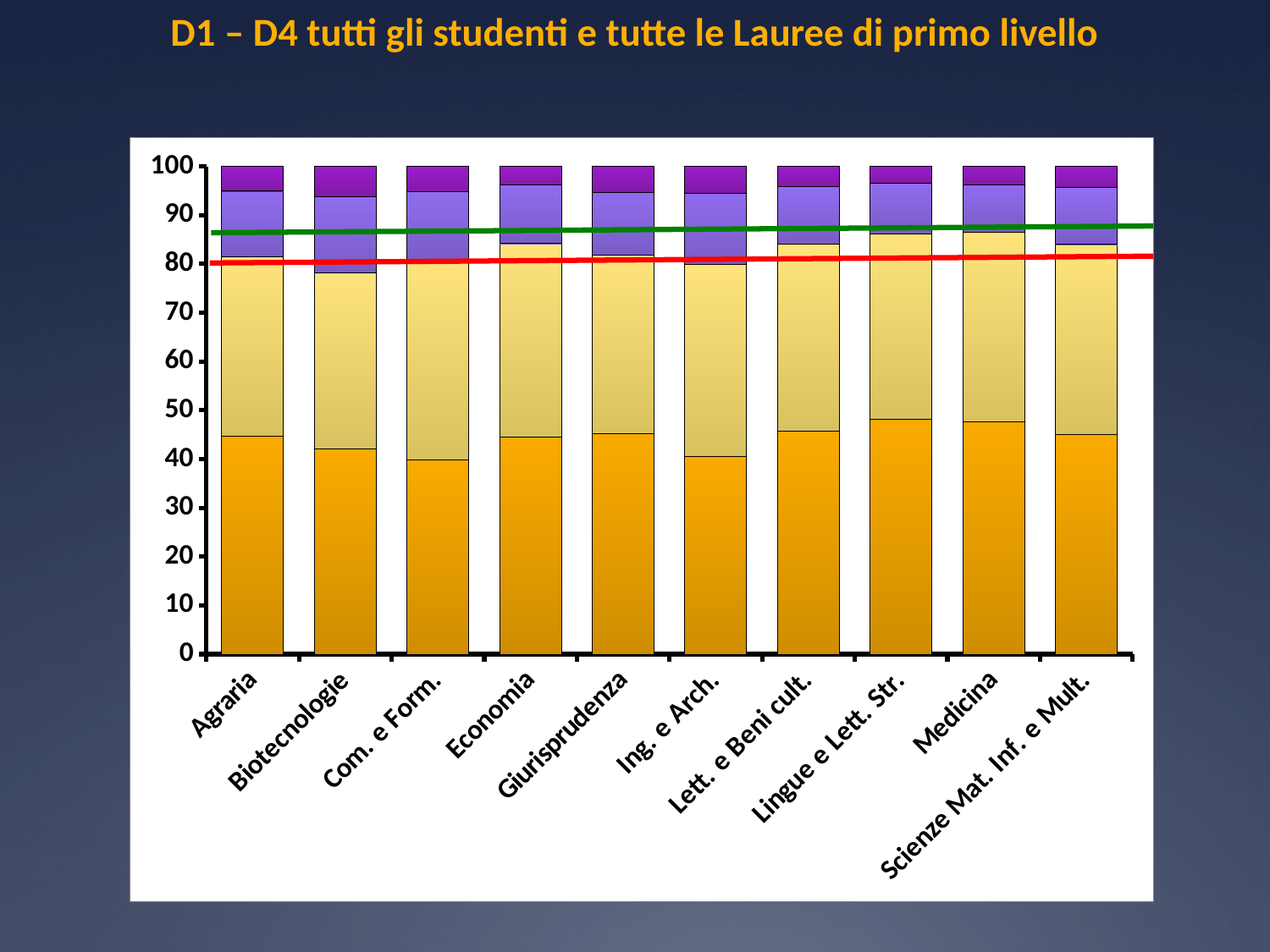
What kind of chart is shown on the slide? stacked bar chart What is the title of the slide? D1 – D4 tutti gli studenti e tutte le Lauree di primo livello Is the bottom (orange) segment for Lingue e Lett. Str. greater or less than 50? less What is the total height of the stacked bar for Medicina? 100 Which has the larger bottom (orange) segment, Lingue e Lett. Str. or Com. e Form.? Lingue e Lett. Str. What colour is the bottom segment of each stacked bar? orange Is the bottom (orange) segment for Biotecnologie greater or less than 40? greater Is the bottom (orange) segment for Com. e Form. greater or less than 50? less How many categories are shown along the x axis of the chart? 10 What is the highest value shown on the y axis? 100 Which has the larger bottom (orange) segment, Agraria or Ing. e Arch.? Agraria